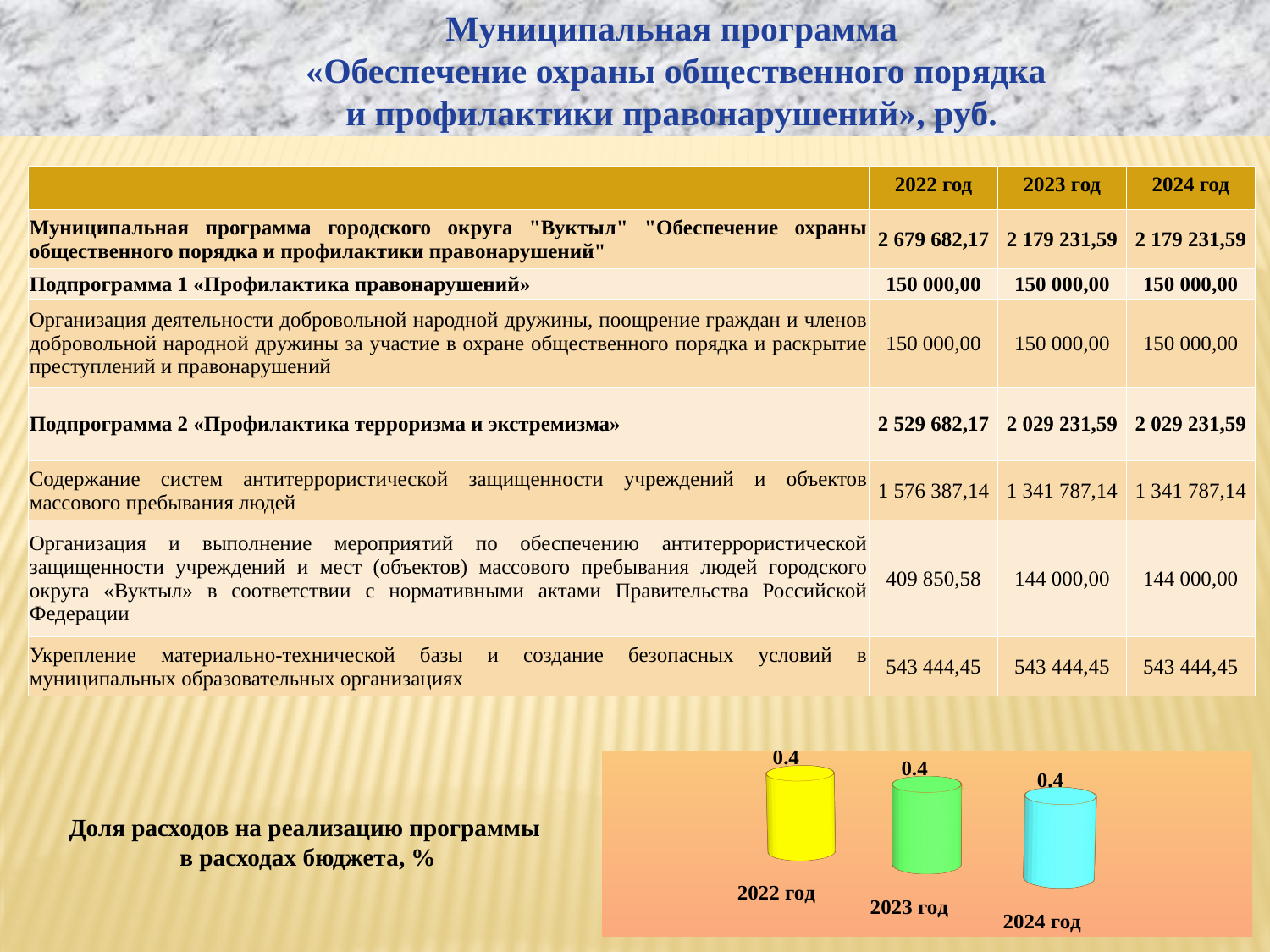
What kind of chart is shown at the bottom of the slide? bar chart Is the value for 2023 год in the chart at the bottom of the slide greater or less than 1? less What colour is the bar for 2024 год in the chart at the bottom of the slide? light blue What colour is the bar for 2022 год in the chart at the bottom of the slide? yellow What is the difference between the values for 2022 год and 2024 год in the chart at the bottom of the slide? 0 What is the value shown for 2022 год in the chart at the bottom of the slide? 0.4 Do the values in the chart at the bottom of the slide rise, fall or stay the same from 2022 год to 2024 год? stay the same What is the value shown for 2024 год in the chart at the bottom of the slide? 0.4 How many categories are plotted in the chart at the bottom of the slide? 3 What is the value shown for 2023 год in the chart at the bottom of the slide? 0.4